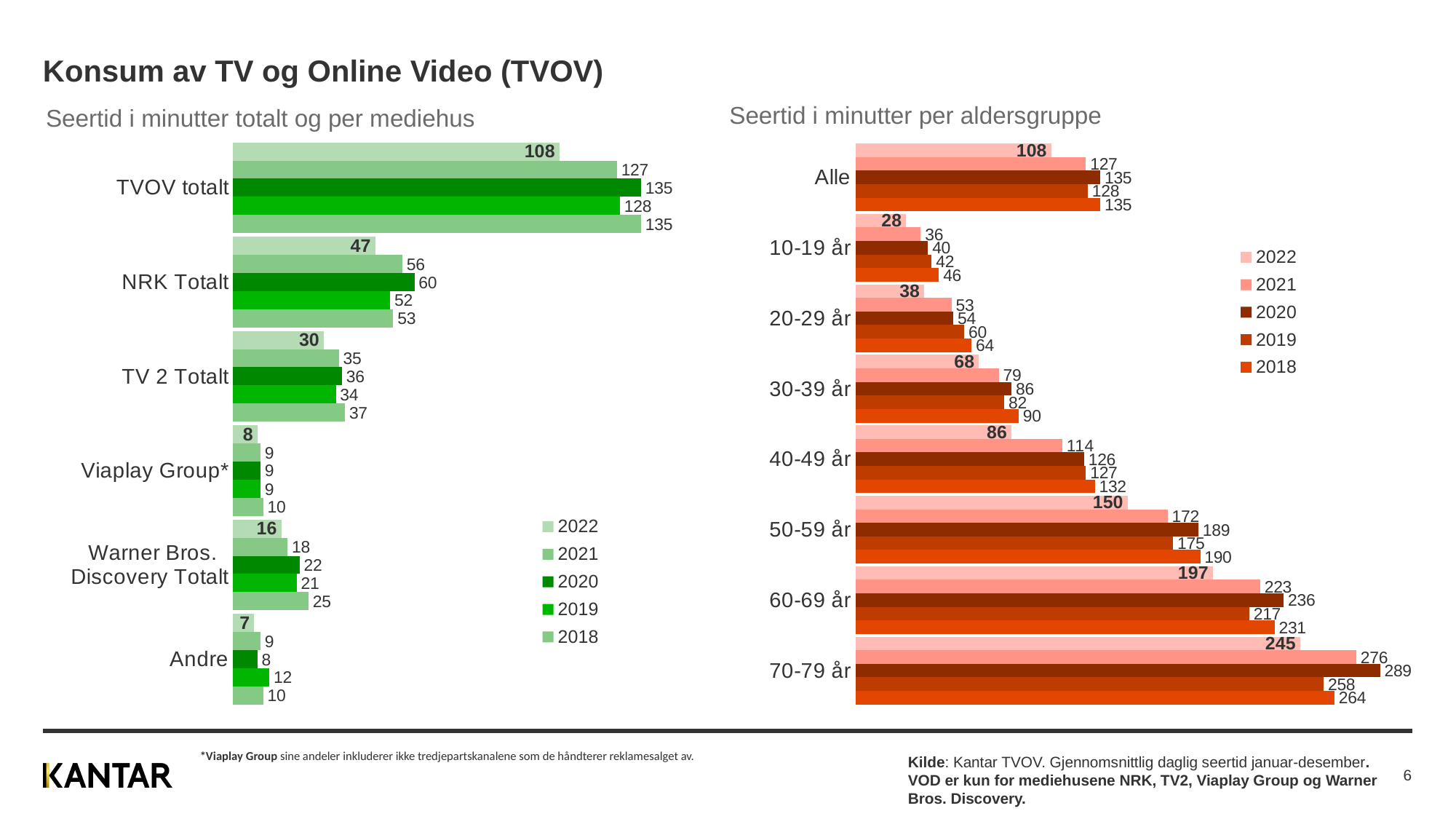
In the chart 'Seertid i minutter totalt og per mediehus', what is the difference between the 2020 and 2022 values for TVOV totalt? 27 How many series does the legend list in the chart 'Seertid i minutter totalt og per mediehus'? 5 In the chart 'Seertid i minutter totalt og per mediehus', what is the 2018 value for Warner Bros. Discovery Totalt? 25 What type of chart is 'Seertid i minutter totalt og per mediehus'? Bar chart In the chart 'Seertid i minutter per aldersgruppe', which age group has the lowest 2018 value? 10-19 år In the chart 'Seertid i minutter per aldersgruppe', which age group has the highest 2022 value? 70-79 år In the chart 'Seertid i minutter per aldersgruppe', what is the difference between the 2021 and 2022 values for 60-69 år? 26 How many categories are shown in the chart 'Seertid i minutter per aldersgruppe'? 8 In the chart 'Seertid i minutter per aldersgruppe', what is the 2020 value for 70-79 år? 289 In the chart 'Seertid i minutter per aldersgruppe', what is the 2022 value for 50-59 år? 150 In the chart 'Seertid i minutter totalt og per mediehus', which is larger for TV 2 Totalt: the 2018 value or the 2019 value? 2018 In the chart 'Seertid i minutter totalt og per mediehus', what is the 2022 value for NRK Totalt? 47